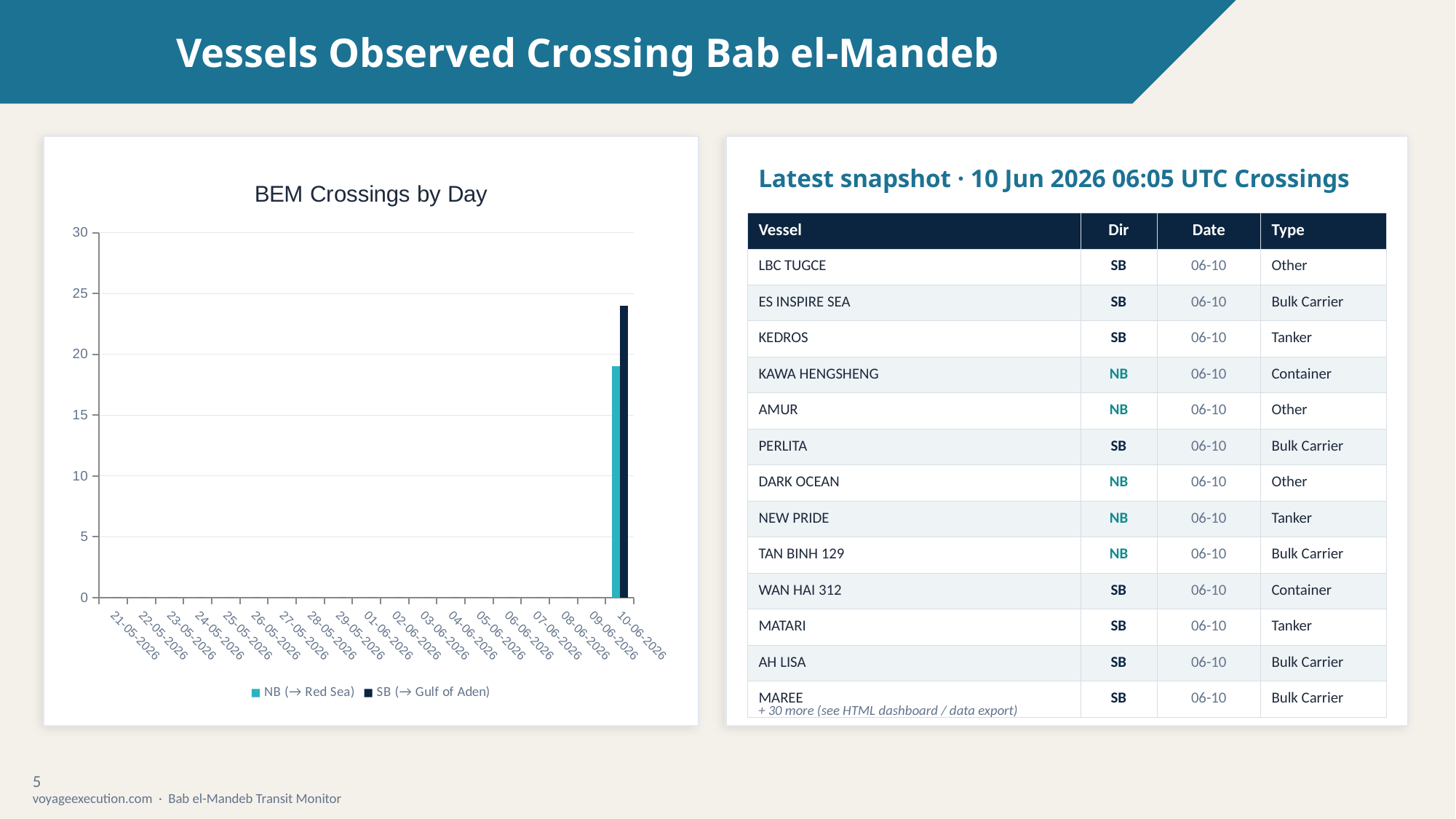
In "BEM Crossings by Day", which date has the highest NB (→ Red Sea) value? 10-06-2026 In "BEM Crossings by Day", on 10-06-2026, which is larger: NB (→ Red Sea) or SB (→ Gulf of Aden)? SB (→ Gulf of Aden) What is the first date shown on the x axis of "BEM Crossings by Day"? 21-05-2026 In "BEM Crossings by Day", is the SB (→ Gulf of Aden) value for 10-06-2026 greater or less than 20? greater What kind of chart is "BEM Crossings by Day"? bar chart In "BEM Crossings by Day", is the NB (→ Red Sea) value for 10-06-2026 greater or less than 15? greater How many dates are shown on the x axis of "BEM Crossings by Day"? 19 How many series does the legend of "BEM Crossings by Day" list? 2 What are the two series named in the legend of "BEM Crossings by Day"? NB (→ Red Sea) and SB (→ Gulf of Aden) In "BEM Crossings by Day", which date has the highest SB (→ Gulf of Aden) value? 10-06-2026 What is the highest value shown on the y axis of "BEM Crossings by Day"? 30 In "BEM Crossings by Day", is the NB (→ Red Sea) value for 10-06-2026 greater or less than 25? less